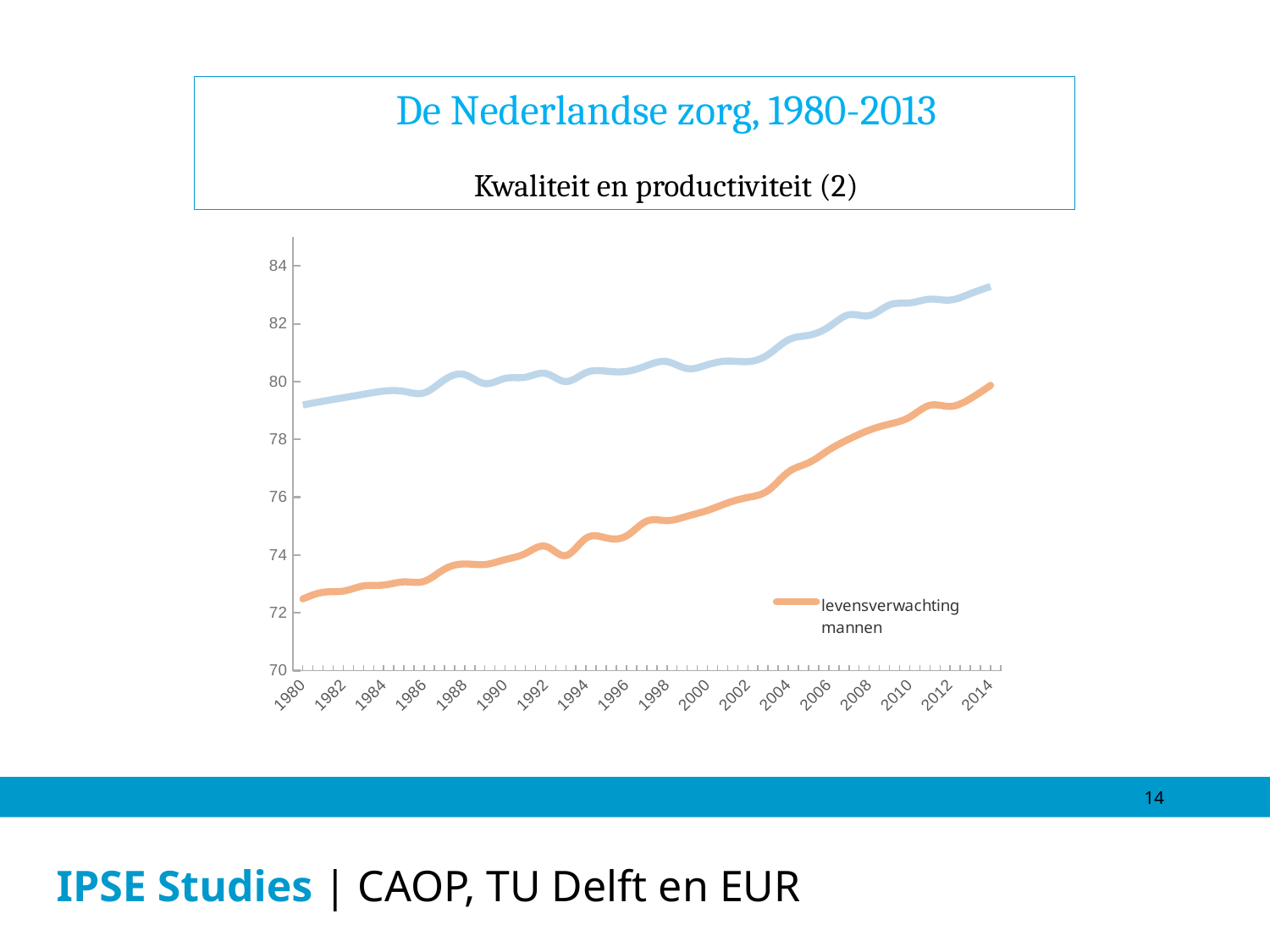
How many year labels are shown on the x axis? 18 How many series does the chart's legend list? 1 Which line is higher in 2010, the blue line or the orange levensverwachting mannen line? the blue line Is the value for levensverwachting mannen in 2013 greater or less than 78? greater Is the value of the blue line in 2013 greater or less than 82? greater Is the value of the blue line in 1980 greater or less than 80? less Does the value for levensverwachting mannen rise or fall from 1980 to 2014? rise What colour is the line for levensverwachting mannen? orange What kind of chart is shown on the slide? line chart What is the series name shown in the chart's legend? levensverwachting mannen